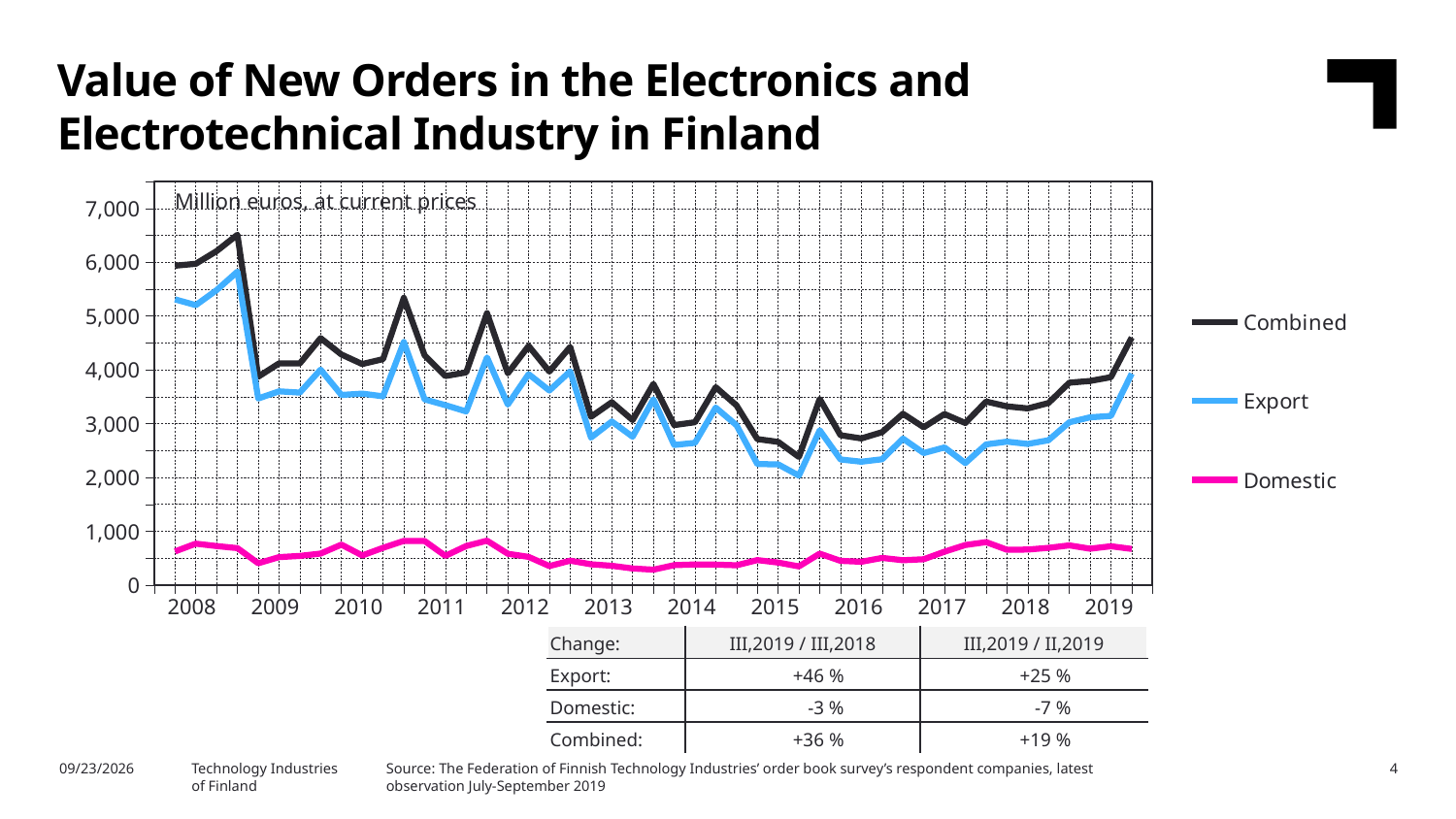
Which series has the lowest values throughout the chart? Domestic How many series does the chart legend list? 3 Which series is larger in 2012, Export or Domestic? Export Which series has the highest values throughout the chart? Combined Is the Domestic value at any point greater or less than 1,000? less Is the Combined value at the start of 2008 greater or less than 5,000? greater How many years are labelled on the x axis? 12 What type of chart is shown on the slide? Line chart What unit is stated in the chart's subtitle? Million euros, at current prices Is the Export value at the last point in 2019 greater or less than 3,000? greater What colour is the Domestic line in the chart? Pink Does the Combined series generally rise or fall from 2008 to 2015? fall